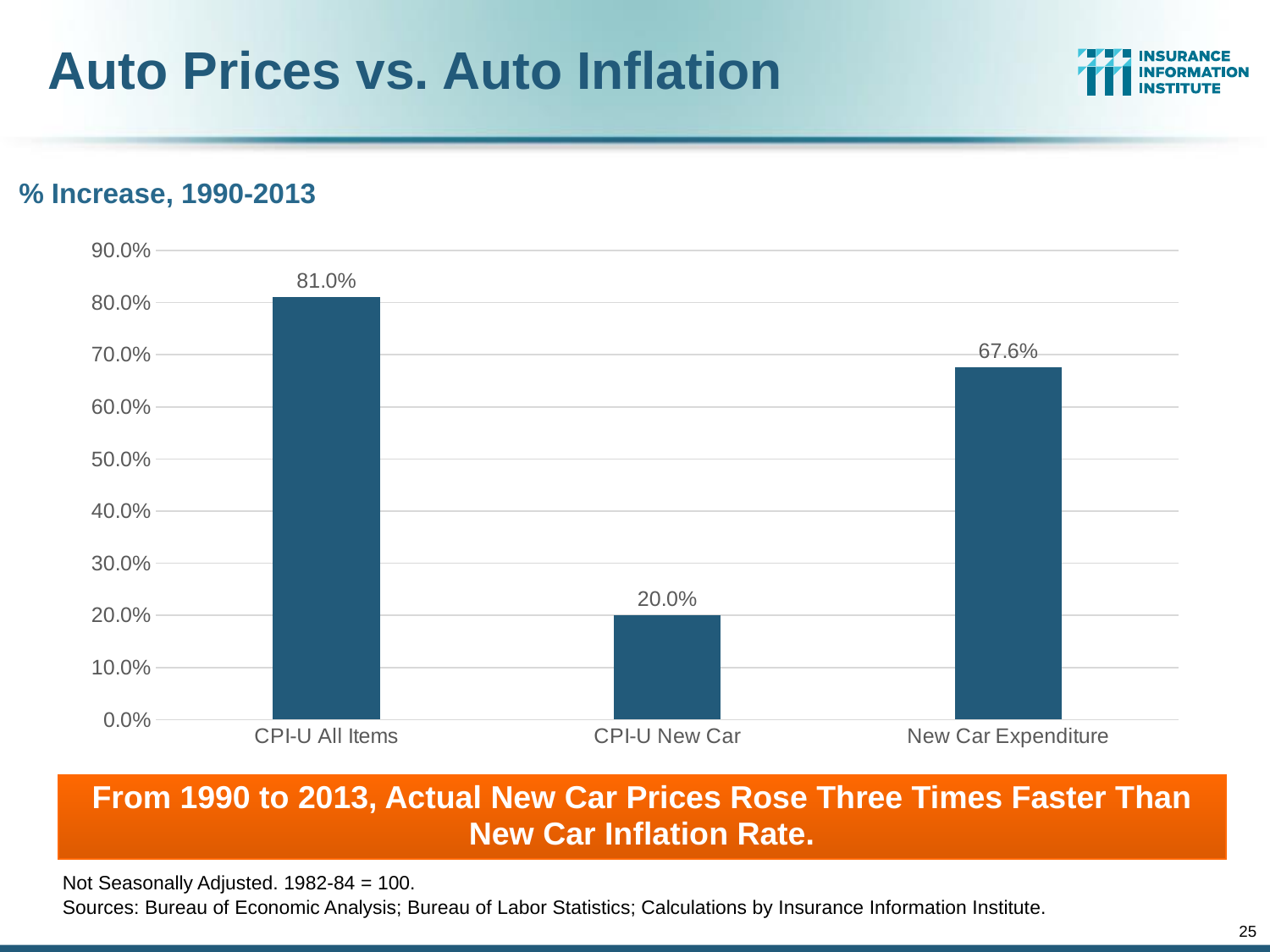
Is the value for New Car Expenditure greater or less than 70.0%? less How many categories are shown on the chart? 3 Which category has the lowest value? CPI-U New Car What is the title of the chart? % Increase, 1990-2013 Which category has the highest value? CPI-U All Items What is the difference between the values for CPI-U All Items and New Car Expenditure? 13.4% What is the value for CPI-U New Car? 20.0% What is the value for New Car Expenditure? 67.6% What is the value for CPI-U All Items? 81.0% What is the difference between the values for New Car Expenditure and CPI-U New Car? 47.6% Which is larger, the value for CPI-U New Car or the value for New Car Expenditure? New Car Expenditure What kind of chart is shown on the slide? bar chart